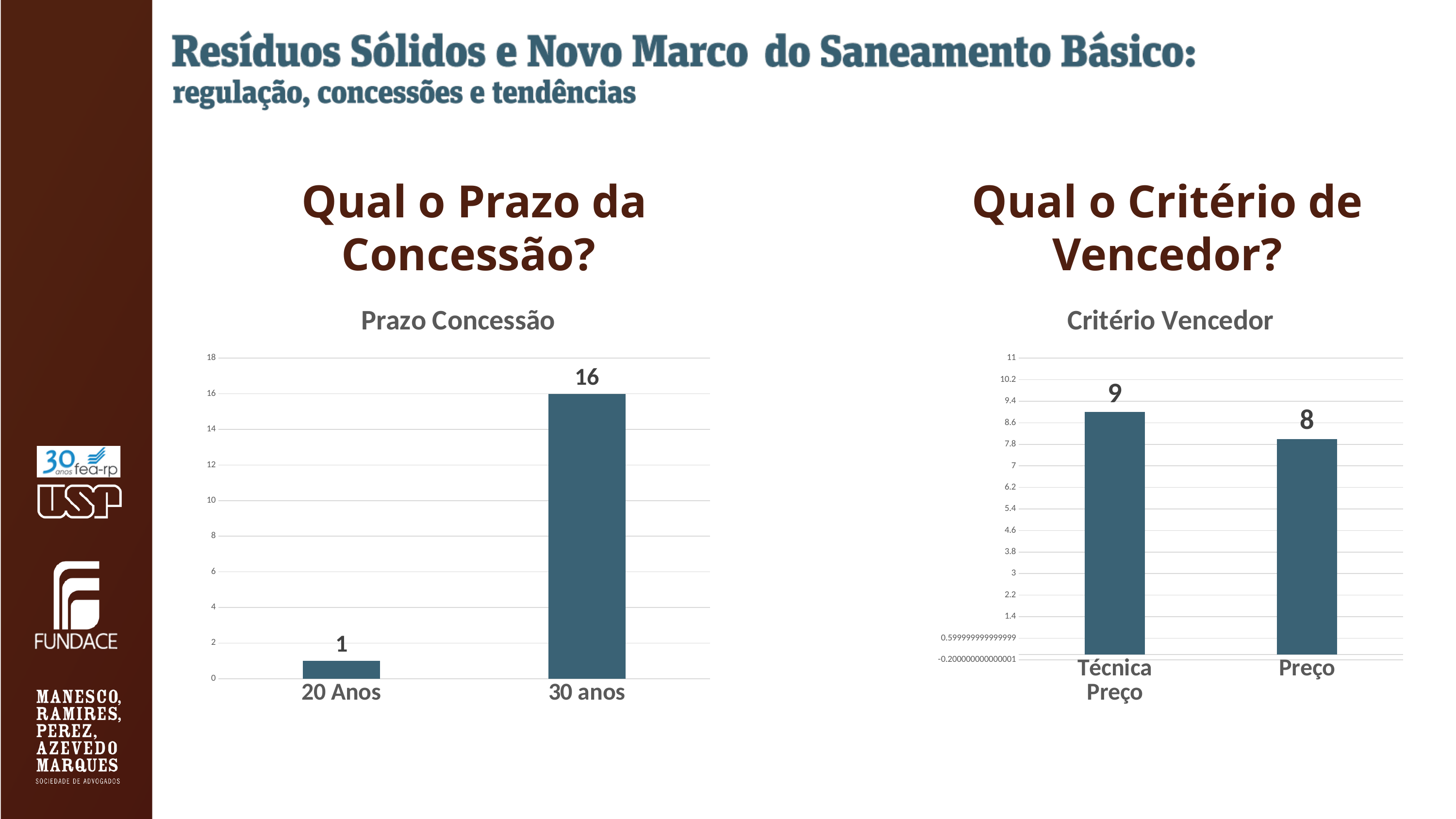
In the "Critério Vencedor" chart, is the value for Técnica Preço greater or less than 7? greater In the "Critério Vencedor" chart, what is the value for Técnica Preço? 9 In the "Prazo Concessão" chart, what is the value for 30 anos? 16 What kind of chart is the "Prazo Concessão" chart? Bar chart In the "Critério Vencedor" chart, which category has the lowest value? Preço In the "Critério Vencedor" chart, what is the difference between the values for Técnica Preço and Preço? 1 In the "Prazo Concessão" chart, how many categories are shown? 2 In the "Critério Vencedor" chart, what is the value for Preço? 8 In the "Prazo Concessão" chart, which category has the highest value? 30 anos In the "Prazo Concessão" chart, what is the value for 20 Anos? 1 In the "Prazo Concessão" chart, what is the difference between the values for 30 anos and 20 Anos? 15 What is the title of the chart on the right side of the slide? Critério Vencedor